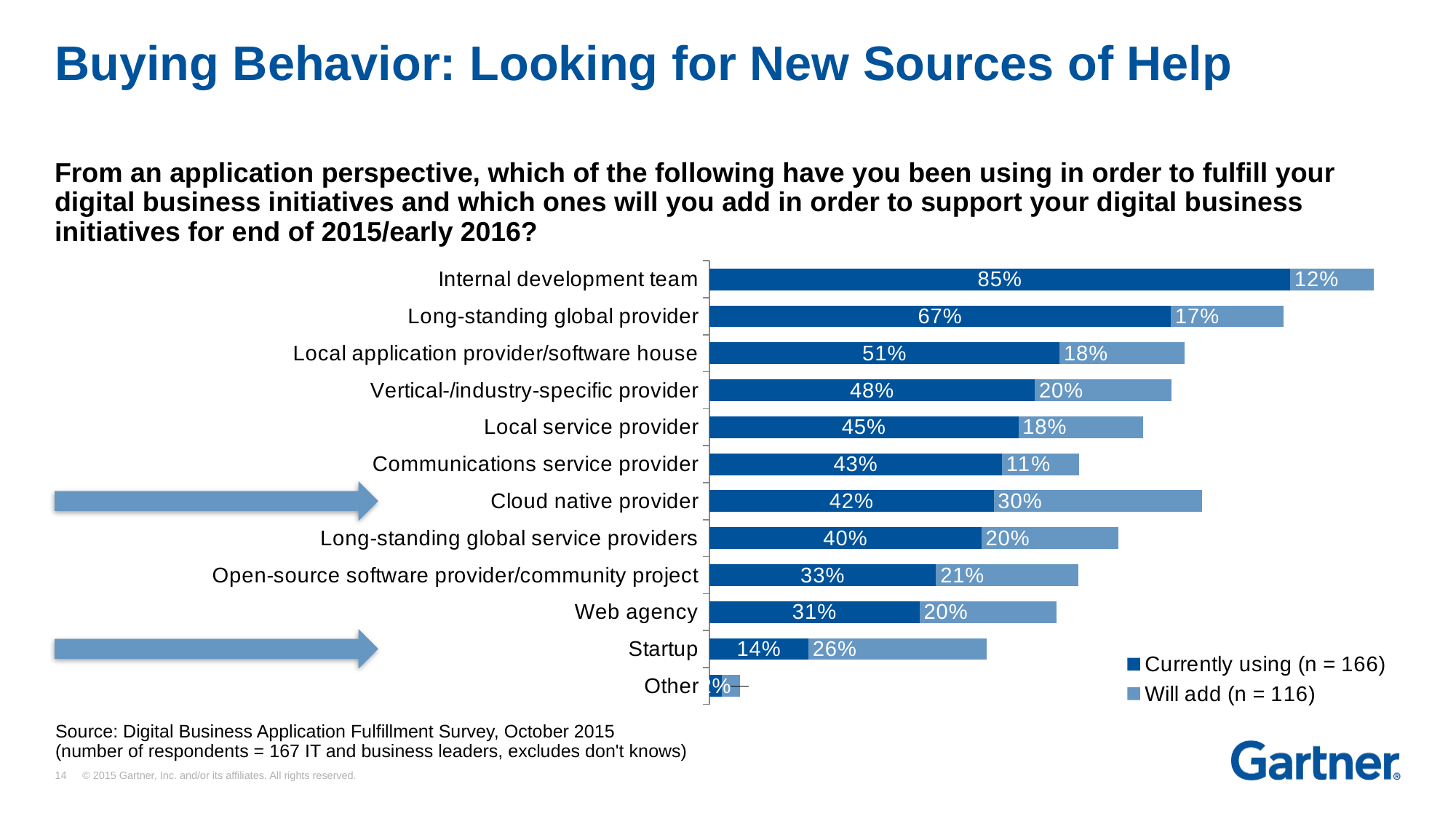
What is the 'Will add' value for Cloud native provider? 30% Which category has the highest 'Will add' value? Cloud native provider What kind of chart is shown on the slide? Stacked bar chart Which is larger: the 'Will add' value for Startup or the 'Will add' value for Web agency? Startup What percentage of respondents are currently using an internal development team? 85% What is the difference between the 'Currently using' values for Internal development team and Long-standing global provider? 18% How many series does the legend list? 2 What are the two series named in the legend? Currently using (n = 166) and Will add (n = 116) Which category has the highest 'Currently using' value? Internal development team What is the total of the stacked bar for Cloud native provider? 72% How many categories are shown on the chart? 12 What is the 'Currently using' value for Startup? 14%